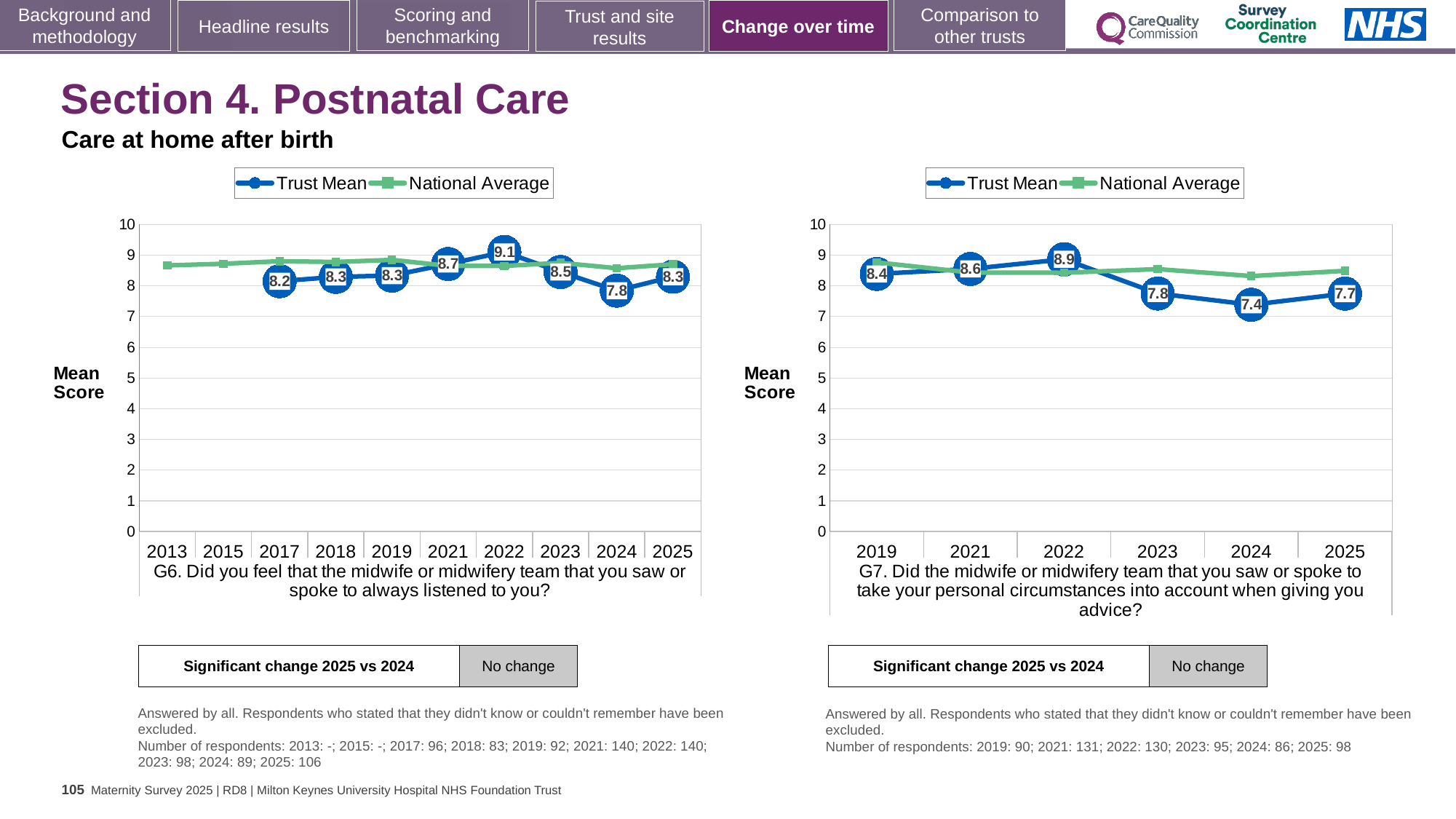
How many series does the legend of the left chart (G6) list? 2 In the right chart (G7), how many years are shown on the x axis? 6 In the right chart (G7), which year has the highest Trust Mean? 2022 In the left chart (G6), which year has the highest Trust Mean? 2022 In the right chart (G7), is the Trust Mean for 2022 or 2025 larger? 2022 In the right chart (G7), what is the Trust Mean for 2023? 7.8 In the left chart (G6), which year has the lowest Trust Mean? 2024 In the right chart (G7), which year has the lowest Trust Mean? 2024 In the right chart (G7), is the National Average for 2024 greater or less than 8? greater In the left chart (G6), what is the Trust Mean for 2024? 7.8 In the left chart (G6), what is the Trust Mean for 2022? 9.1 In the left chart (G6), what is the difference between the Trust Mean for 2022 and 2024? 1.3